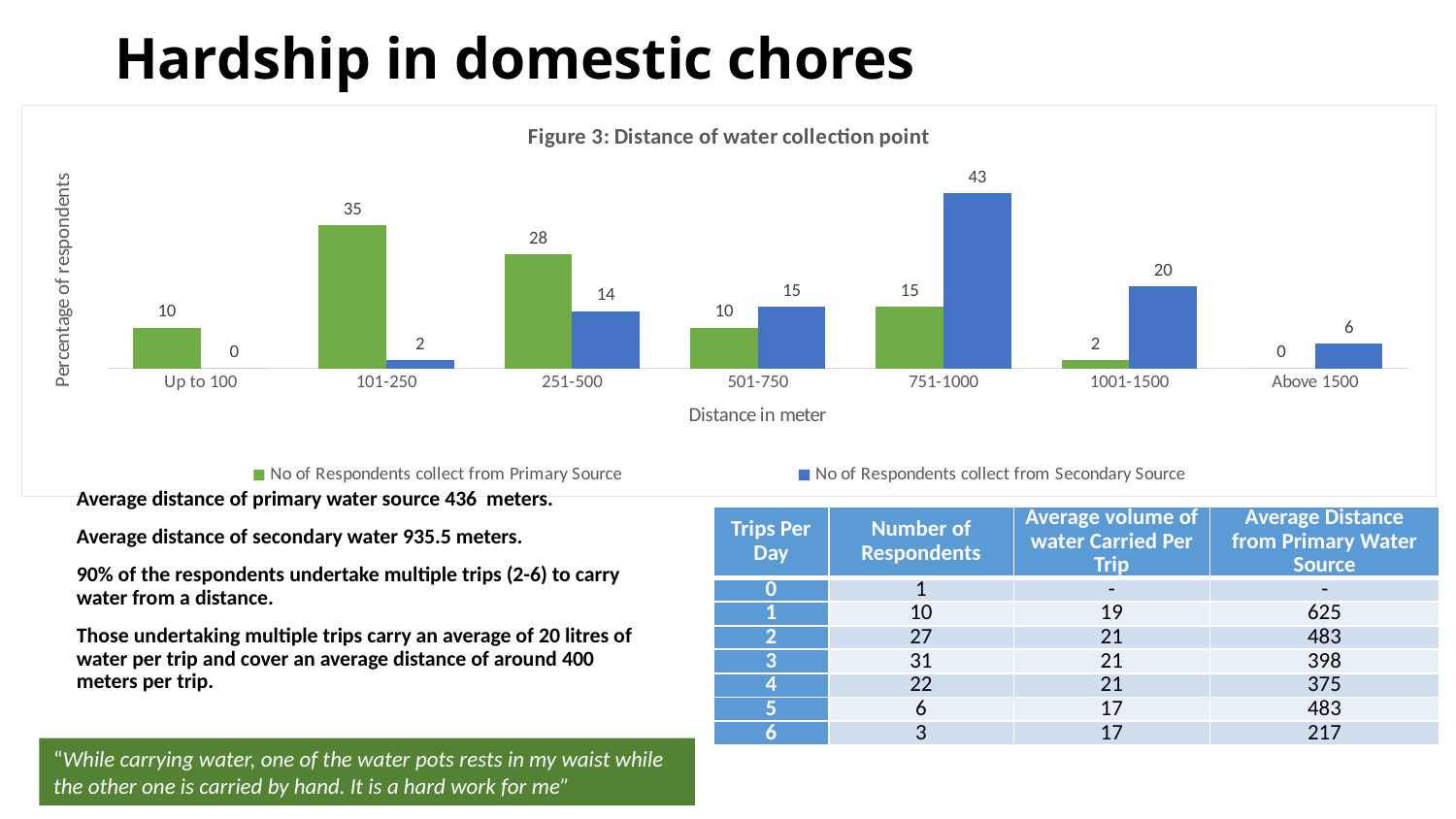
What is the value for Secondary Source in the 751-1000 category? 43 Which distance category has the lowest value for Primary Source? Above 1500 How many distance categories are shown on the x axis? 7 What is the title of the chart? Figure 3: Distance of water collection point What kind of chart is shown? Bar chart What is the difference between the Secondary Source and Primary Source values in the 751-1000 category? 28 What is the label of the y axis? Percentage of respondents Which distance category has the highest value for Secondary Source? 751-1000 How many series does the legend list? 2 What is the value for Secondary Source in the Up to 100 category? 0 What is the value for Primary Source in the 101-250 category? 35 In the 251-500 category, which is larger: Primary Source or Secondary Source? Primary Source